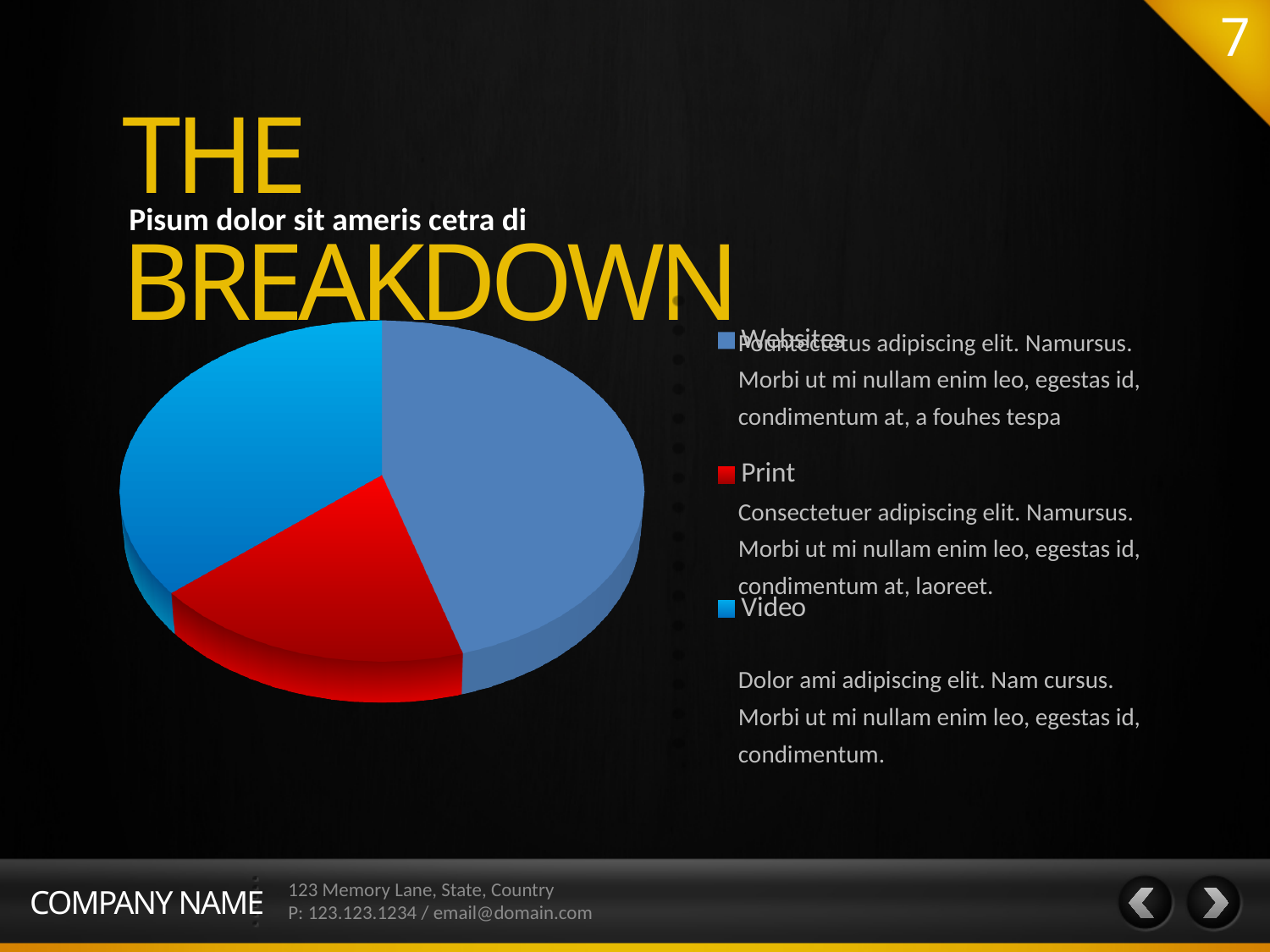
What are the three categories listed in the pie chart's legend? Websites, Print, Video What kind of chart is shown on the slide? pie chart What colour is the Print slice in the pie chart? red Which category has the largest slice of the pie chart? Websites How many entries does the pie chart's legend list? 3 How many slices does the pie chart have? 3 Which category has the smallest slice of the pie chart? Print Which slice is larger in the pie chart, Video or Print? Video Which slice is larger in the pie chart, Websites or Print? Websites